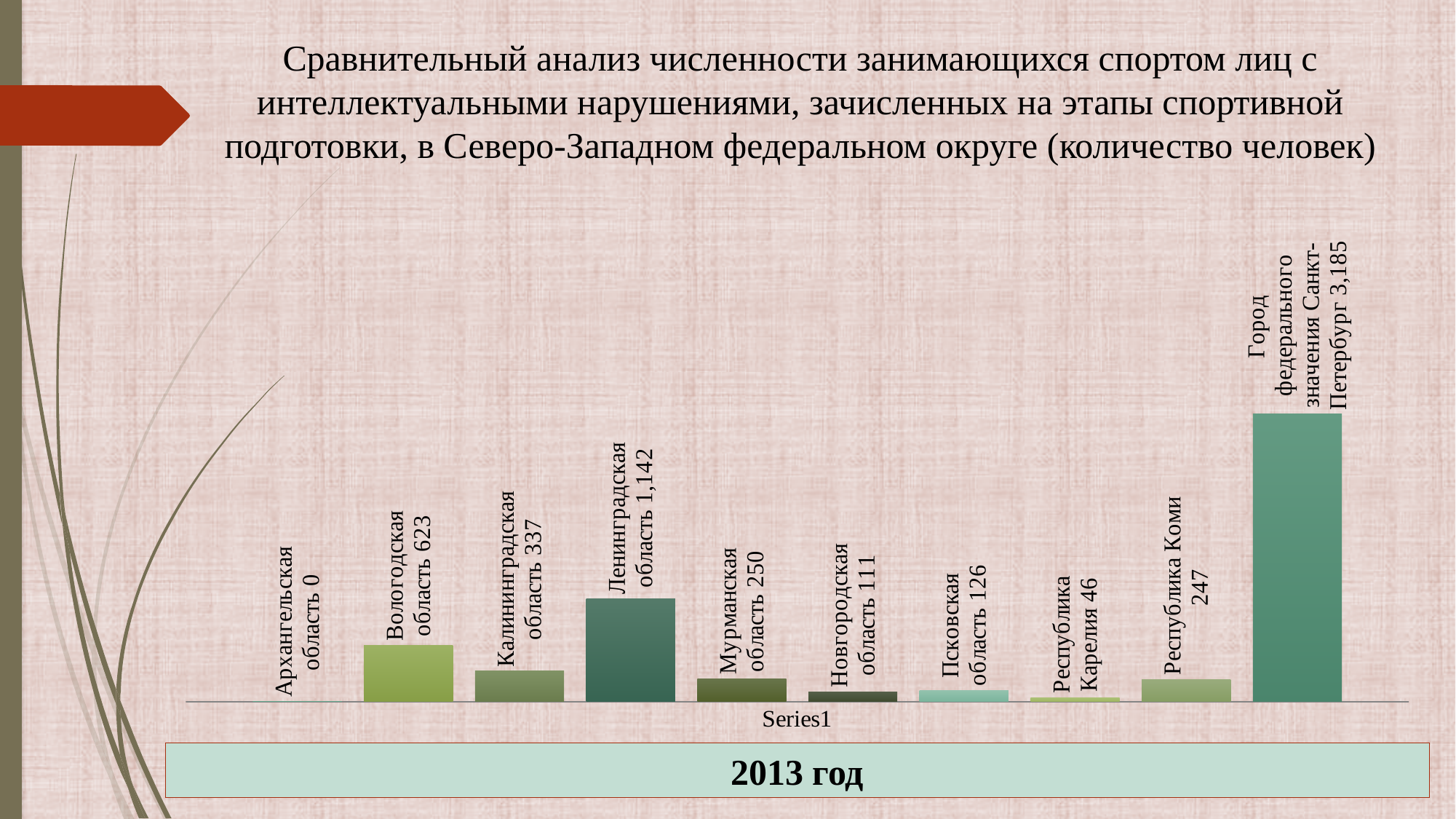
What is the value for Ленинградская область? 1,142 How many categories are shown in the chart? 10 What is the value for Республика Карелия? 46 Which year is shown in the box below the chart? 2013 год Which is larger, the value for Мурманская область or the value for Республика Коми? Мурманская область Which is larger, the value for Псковская область or the value for Новгородская область? Псковская область What is the value for Вологодская область? 623 What is the difference between the values for Вологодская область and Калининградская область? 286 What kind of chart is shown on the slide? Bar chart Which category has the highest value? Город федерального значения Санкт-Петербург Which category has the lowest value? Архангельская область What is the value for Город федерального значения Санкт-Петербург? 3,185